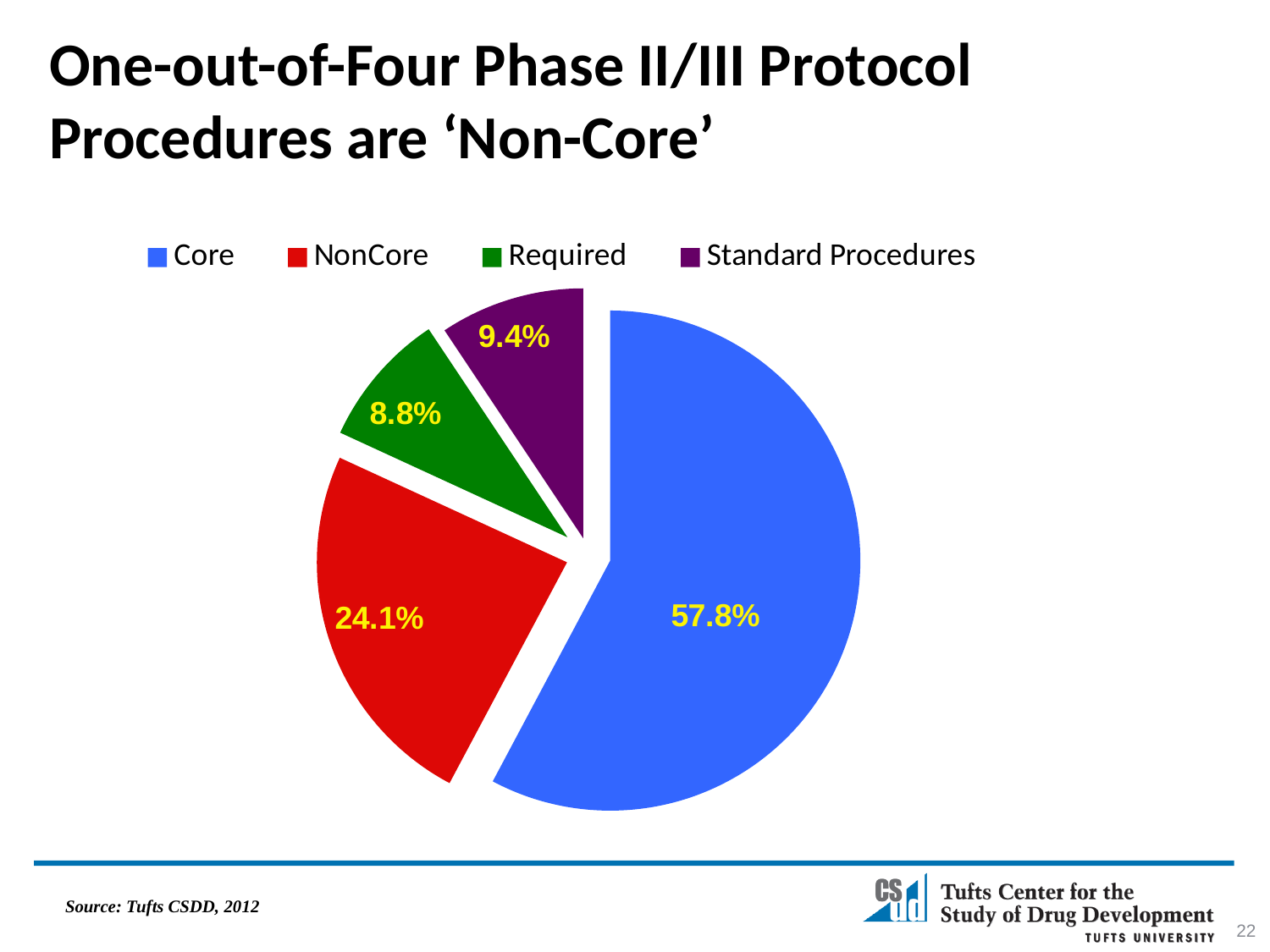
What kind of chart is shown on the slide? pie chart What is the value shown for NonCore? 24.1% Which category has the smallest slice of the pie? Required How many categories does the pie chart show? 4 What share of the pie does the Core slice represent? 57.8% What colour is the NonCore slice? red What is the value shown for Standard Procedures? 9.4% Which category has the largest slice of the pie? Core What is the difference between the Core and NonCore percentages? 33.7% What is the combined percentage of Required and Standard Procedures? 18.2% What is the value shown for Required? 8.8% Which is larger, the Standard Procedures slice or the Required slice? Standard Procedures